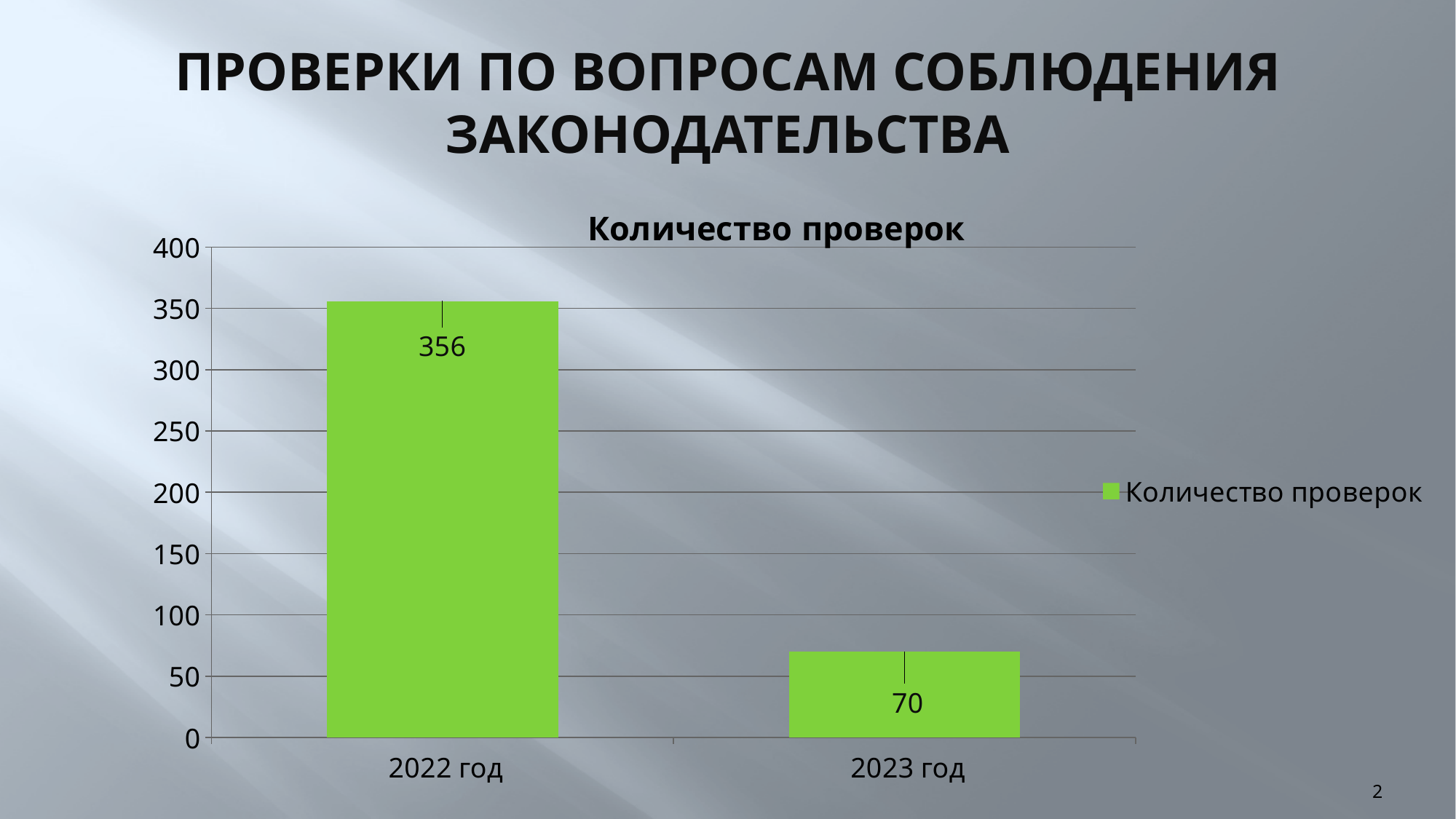
What is the difference between the values for 2022 год and 2023 год? 286 How many series does the legend list? 1 How many categories are shown on the x axis? 2 Which category has the lowest value? 2023 год What is the value for 2023 год? 70 Which is larger, the value for 2022 год or the value for 2023 год? 2022 год Is the value for 2022 год greater or less than 300? greater Which category has the highest value? 2022 год What is the value for 2022 год? 356 What is the title of the chart? Количество проверок What kind of chart is shown? bar chart Is the value for 2023 год greater or less than 100? less